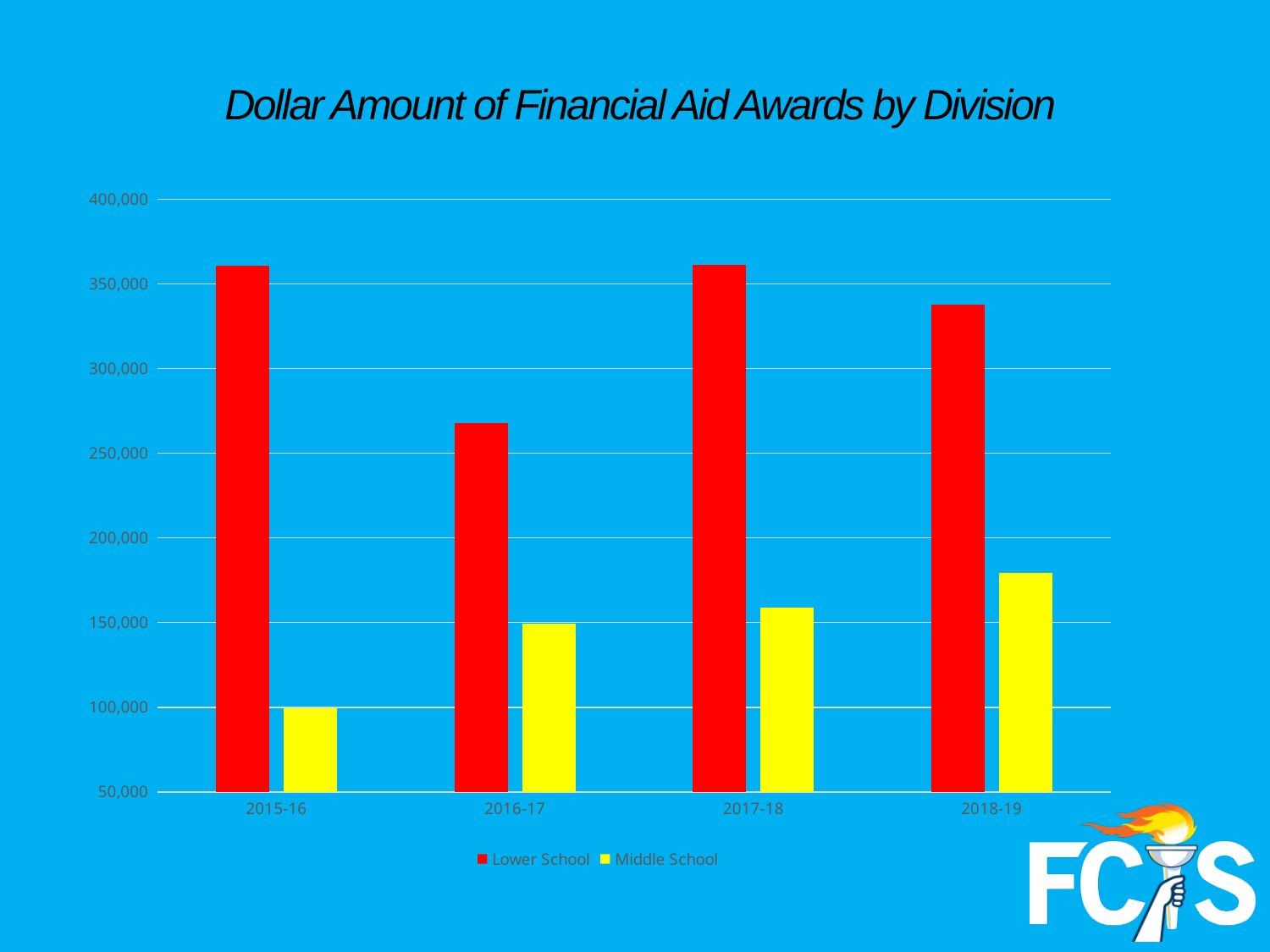
How many series does the legend list? 2 Which school year has the highest Middle School value? 2018-19 Is the Middle School value for 2018-19 greater or less than 200,000? less Is the Lower School value for 2018-19 greater or less than 300,000? greater What is the title of the chart? Dollar Amount of Financial Aid Awards by Division What kind of chart is shown on the slide? bar chart Do the Middle School values rise or fall from 2015-16 to 2018-19? rise How many school years are shown on the x axis? 4 In 2018-19, which is larger, the Lower School value or the Middle School value? Lower School Which school year has the lowest Lower School value? 2016-17 Which school year has the lowest Middle School value? 2015-16 Is the Lower School value for 2016-17 greater or less than 250,000? greater